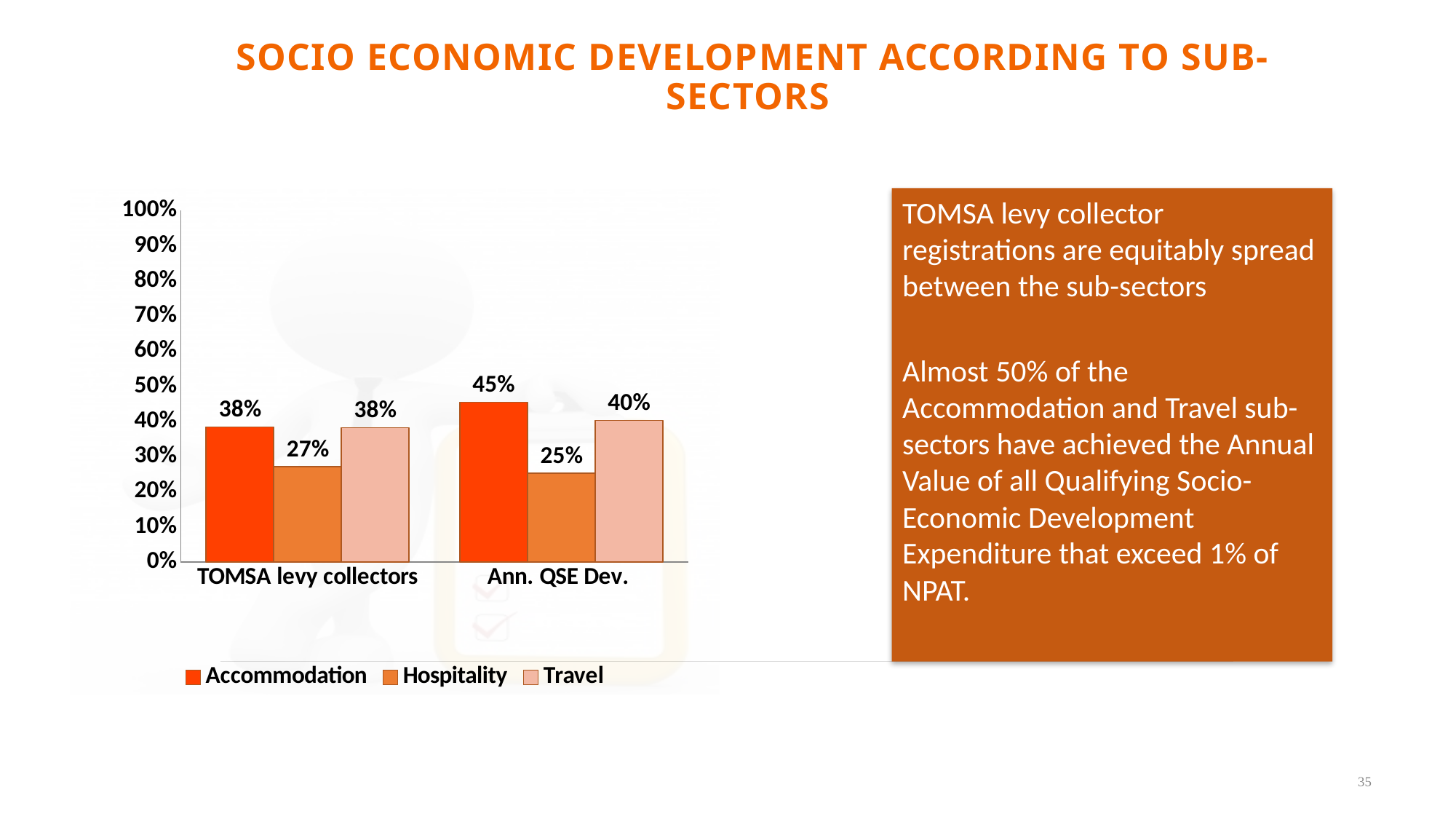
What is the value for Hospitality in the Ann. QSE Dev. category? 25% Which series has the lowest value in the TOMSA levy collectors category? Hospitality How many series does the chart legend list? 3 What is the value for Accommodation in the TOMSA levy collectors category? 38% How many categories are shown on the x axis of the chart? 2 Which series has the highest value in the Ann. QSE Dev. category? Accommodation What is the difference between the Accommodation and Hospitality values in the Ann. QSE Dev. category? 20% What is the value for Travel in the Ann. QSE Dev. category? 40% What kind of chart is shown on the slide? Bar chart What is the value for Hospitality in the TOMSA levy collectors category? 27% Which is larger: the Travel value for TOMSA levy collectors or the Travel value for Ann. QSE Dev.? Ann. QSE Dev. Which series is shown in the lightest colour in the chart legend? Travel